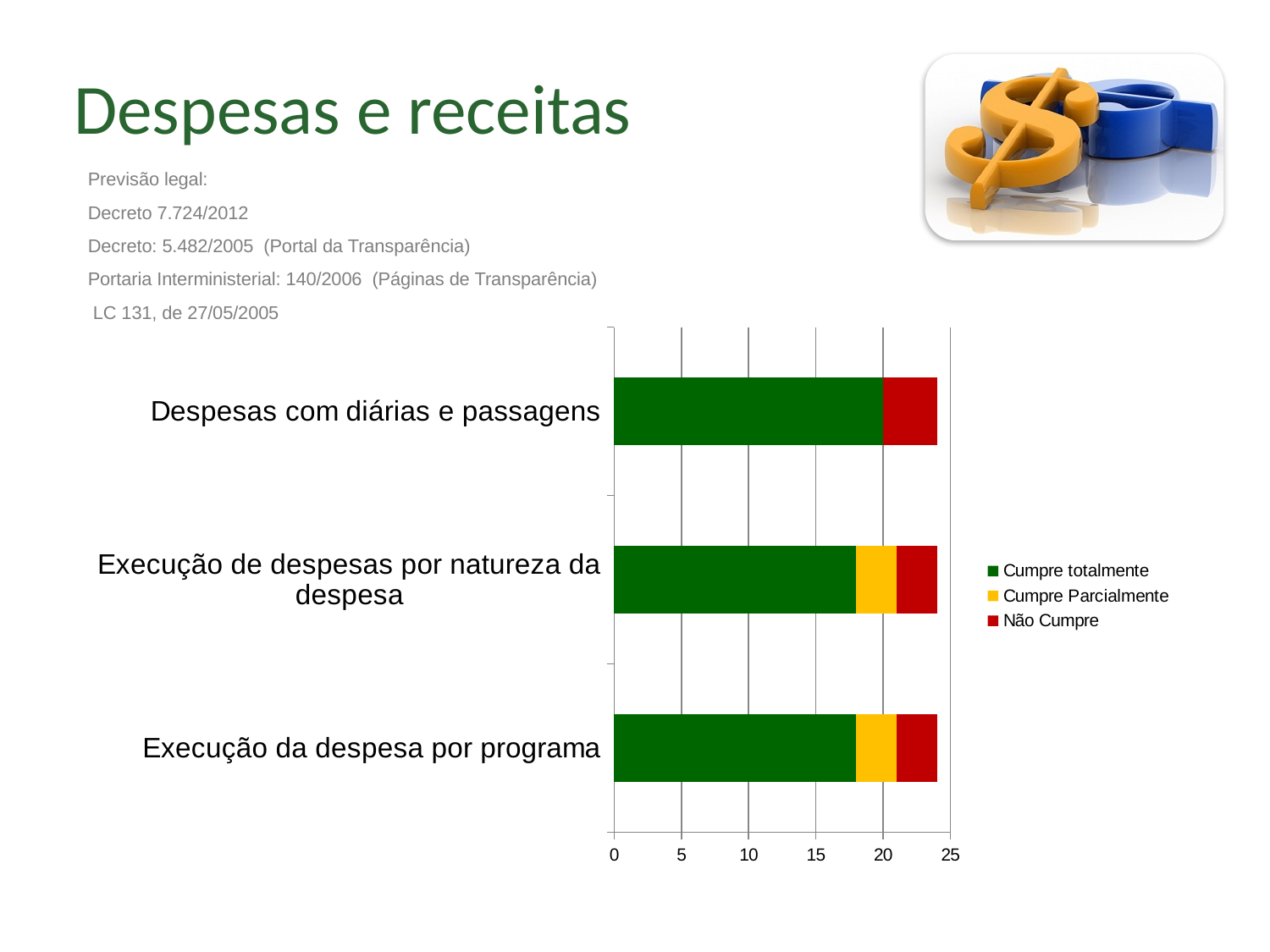
What is the value of "Cumpre totalmente" for "Despesas com diárias e passagens"? 20 Is the "Cumpre totalmente" value for "Execução da despesa por programa" greater or less than 20? less How many categories are plotted on the chart? 3 Is the "Cumpre totalmente" value for "Execução de despesas por natureza da despesa" greater or less than 15? greater What colour represents "Não Cumpre" in the chart? Red How many series does the chart legend list? 3 What kind of chart is shown on the slide? Stacked bar chart Which category has the highest value for "Cumpre totalmente"? Despesas com diárias e passagens What is the highest value shown on the horizontal axis? 25 Which category has no "Cumpre Parcialmente" segment? Despesas com diárias e passagens Is the total length of the bar for "Despesas com diárias e passagens" greater or less than 20? greater Which is larger: the "Cumpre totalmente" value for "Despesas com diárias e passagens" or for "Execução da despesa por programa"? Despesas com diárias e passagens